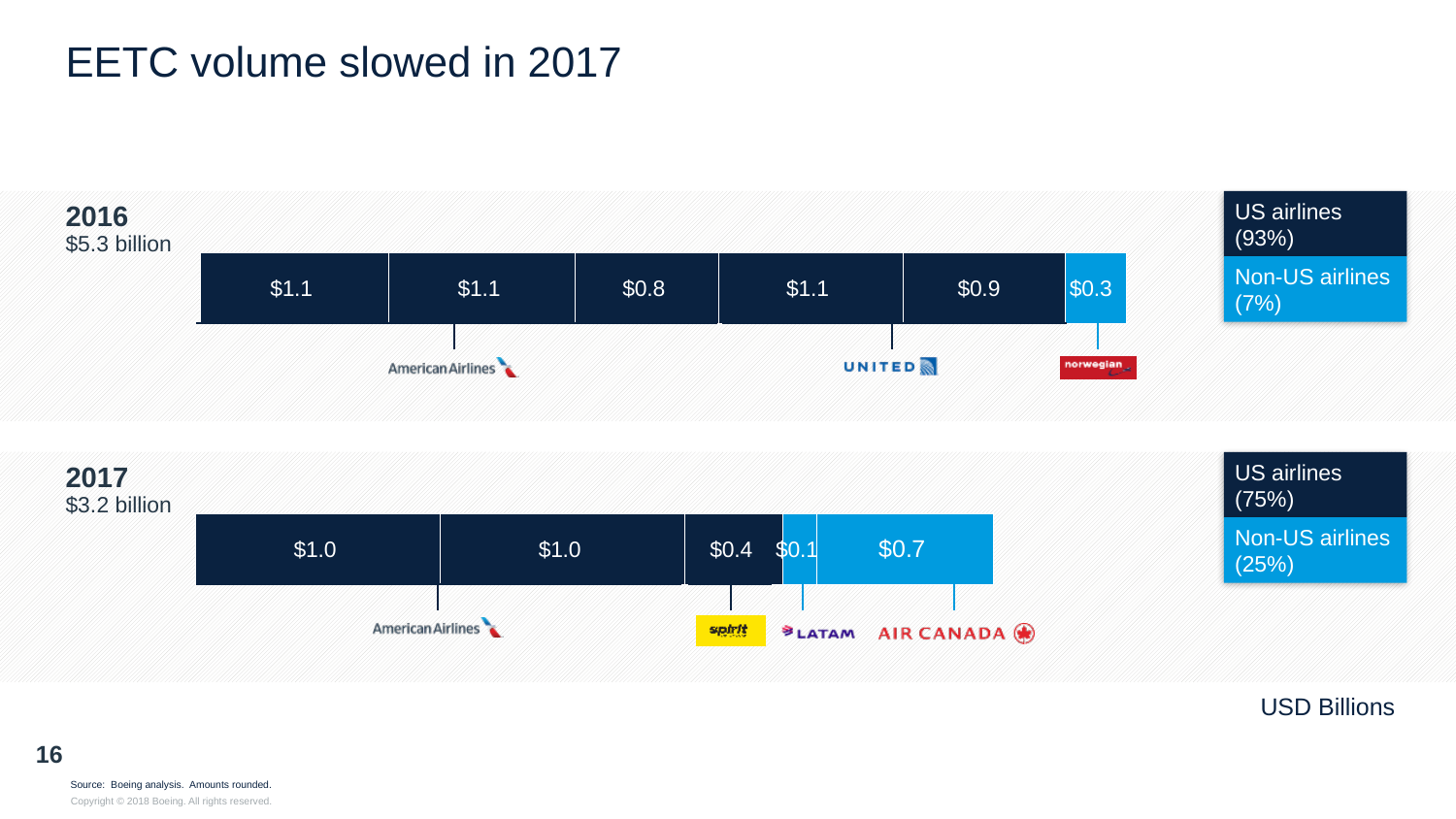
In the 2016 chart, which airline has the smallest segment? Norwegian In the 2017 chart, which airline has the smallest segment? LATAM How many segments make up the 2016 bar? 6 What is the total EETC volume shown for 2016? $5.3 billion How many segments make up the 2017 bar? 5 What share of 2017 EETC volume came from non-US airlines? 25% In the 2017 chart, what is the value of the Spirit segment? $0.4 What kind of chart is used to show the 2016 and 2017 EETC volumes? Stacked bar chart In the 2017 chart, what is the value of the Air Canada segment? $0.7 In the 2016 chart, what is the value of the Norwegian segment? $0.3 By how much did the total EETC volume fall from 2016 to 2017, in USD billions? $2.1 billion What is the total EETC volume shown for 2017? $3.2 billion